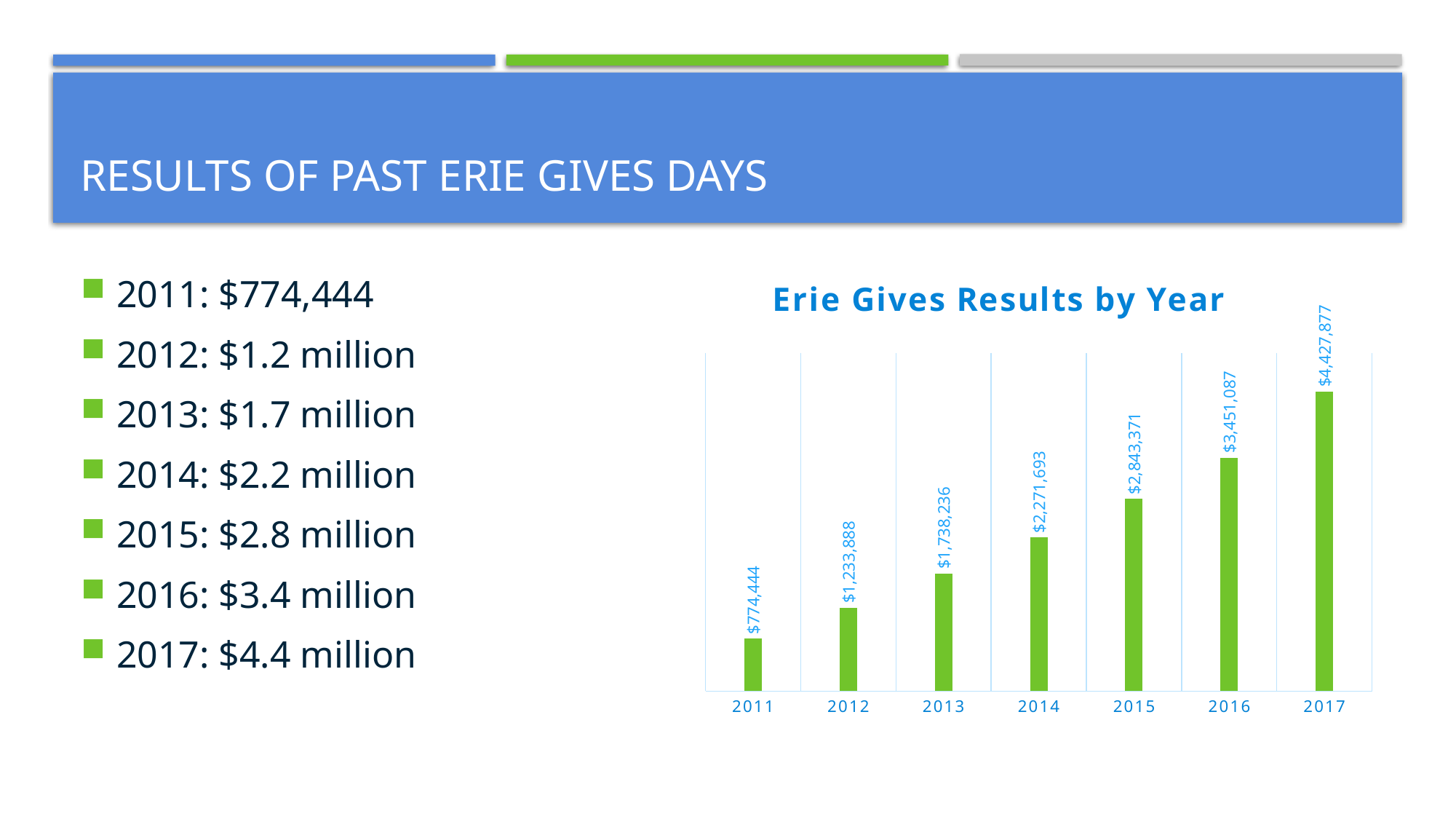
What is the difference between the values for 2012 and 2011? $459,444 How many years are shown on the x axis of the chart? 7 Do the values rise or fall from 2011 to 2017? Rise Which year has the highest value in the chart? 2017 Which year has the lowest value in the chart? 2011 What is the value for 2014 in the chart? $2,271,693 What is the difference between the values for 2017 and 2016? $976,790 What is the value for 2011 in the chart? $774,444 Which is larger, the value for 2013 or the value for 2015? 2015 What is the title of the chart? Erie Gives Results by Year What kind of chart is shown on the slide? Bar chart What is the value for 2016 in the chart? $3,451,087